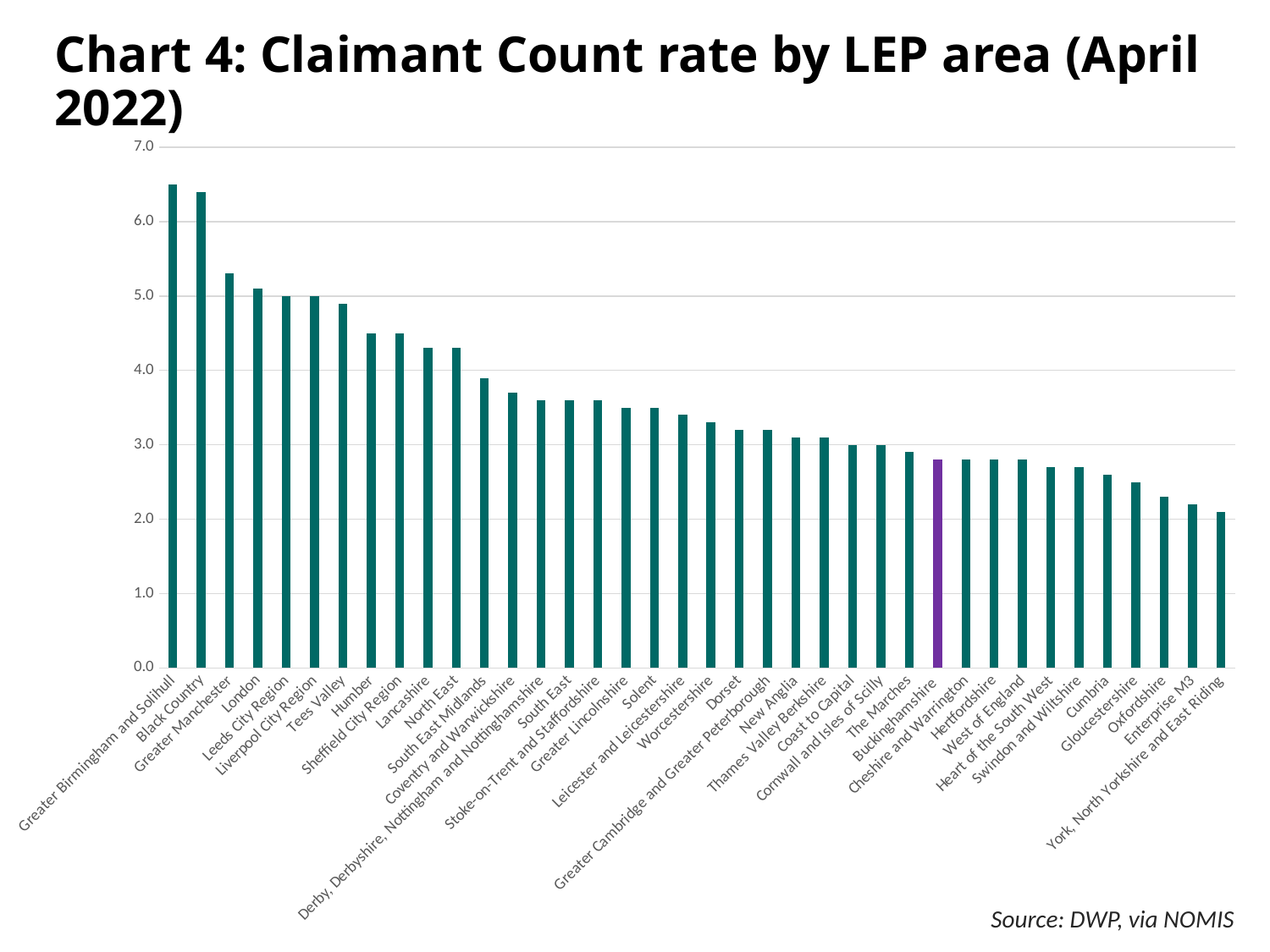
How many LEP areas are plotted on the chart? 38 Which LEP area has the lowest Claimant Count rate? York, North Yorkshire and East Riding Is the value for Black Country greater or less than 6.0? greater Which has the higher Claimant Count rate, Humber or Cumbria? Humber Which has the higher Claimant Count rate, Greater Manchester or Tees Valley? Greater Manchester Which LEP area has the highest Claimant Count rate? Greater Birmingham and Solihull Is the value for Buckinghamshire greater or less than 3.0? less Which LEP area's bar is shown in a different colour (purple) from the rest? Buckinghamshire Is the value for Oxfordshire greater or less than 3.0? less Do the values rise or fall moving from left to right along the x axis? Fall What kind of chart is shown on the slide? Bar chart